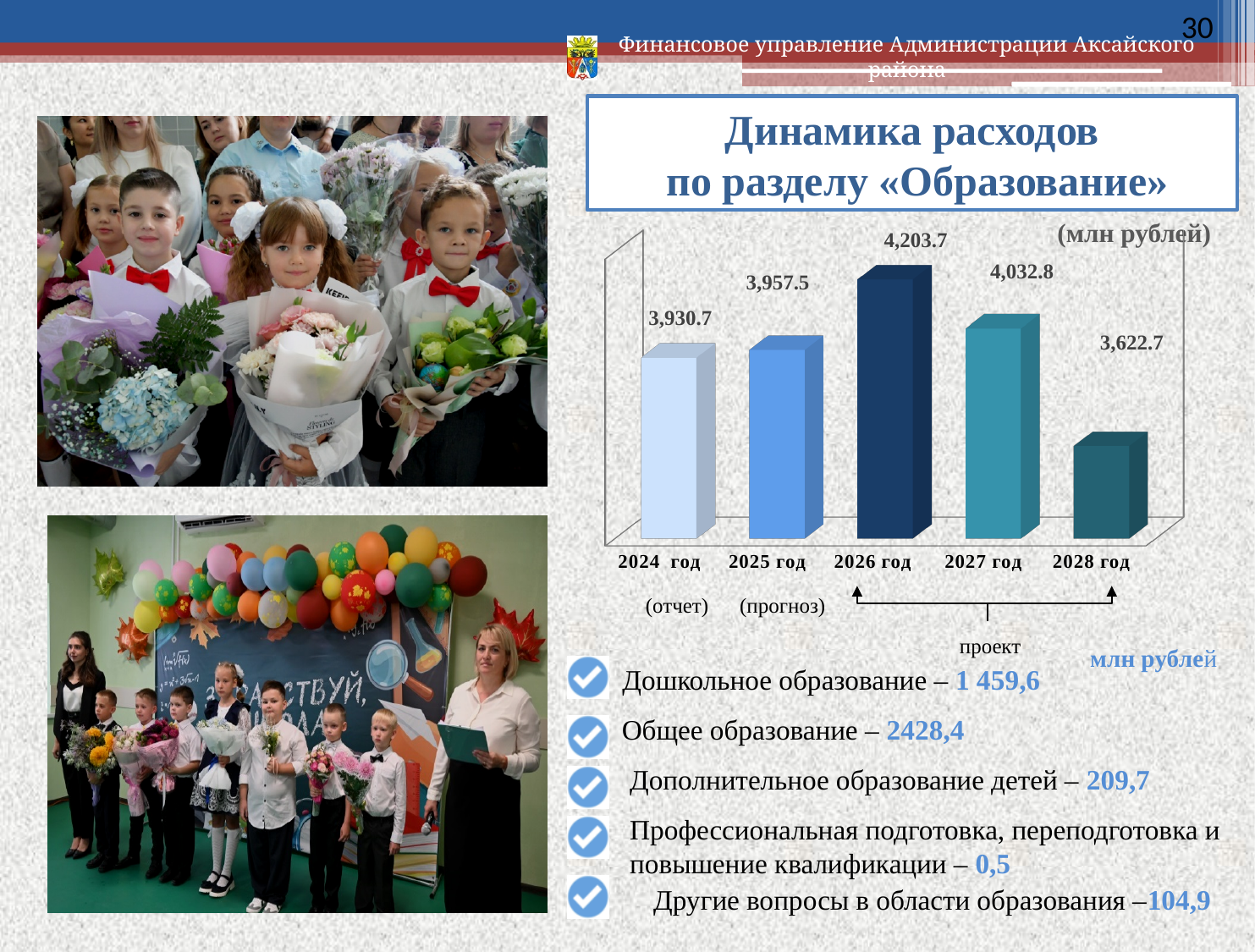
What is the difference between the values for 2026 год and 2025 год? 246.2 What is the value for 2024 год in the chart? 3,930.7 Which year has the lowest value in the chart? 2028 год What is the value for 2027 год in the chart? 4,032.8 What is the value for 2026 год in the chart? 4,203.7 What is the difference between the values for 2027 год and 2028 год? 410.1 Do the values rise or fall from 2026 год to 2028 год? Fall Which is larger, the value for 2027 год or the value for 2025 год? 2027 год What is the value for 2028 год in the chart? 3,622.7 What kind of chart is shown on the slide? Bar chart How many years (bars) are shown in the chart? 5 Which year has the highest value in the chart? 2026 год